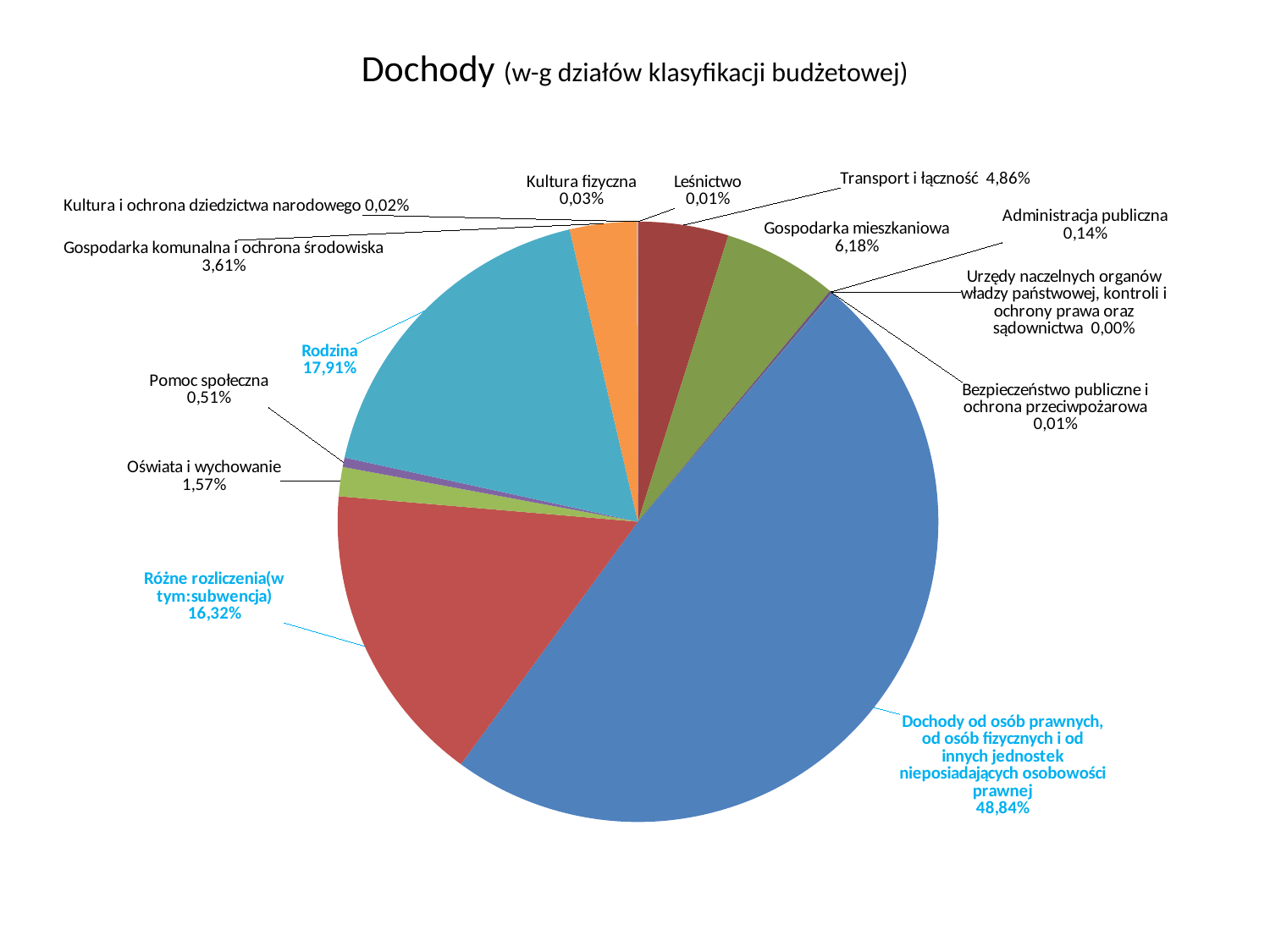
Which is larger: Rodzina or Różne rozliczenia (w tym: subwencja)? Rodzina What is the value shown for Transport i łączność? 4,86% What share of the pie does Rodzina represent? 17,91% What is the title of the chart? Dochody (w-g działów klasyfikacji budżetowej) What is the value shown for Oświata i wychowanie? 1,57% Which category has the largest share of the pie? Dochody od osób prawnych, od osób fizycznych i od innych jednostek nieposiadających osobowości prawnej Which category has the smallest share of the pie? Urzędy naczelnych organów władzy państwowej, kontroli i ochrony prawa oraz sądownictwa What type of chart is shown on the slide? Pie chart What is the difference in percentage points between Rodzina and Różne rozliczenia (w tym: subwencja)? 1,59 What is the value shown for Gospodarka mieszkaniowa? 6,18% How many categories are shown in the pie chart? 14 What is the value shown for Gospodarka komunalna i ochrona środowiska? 3,61%